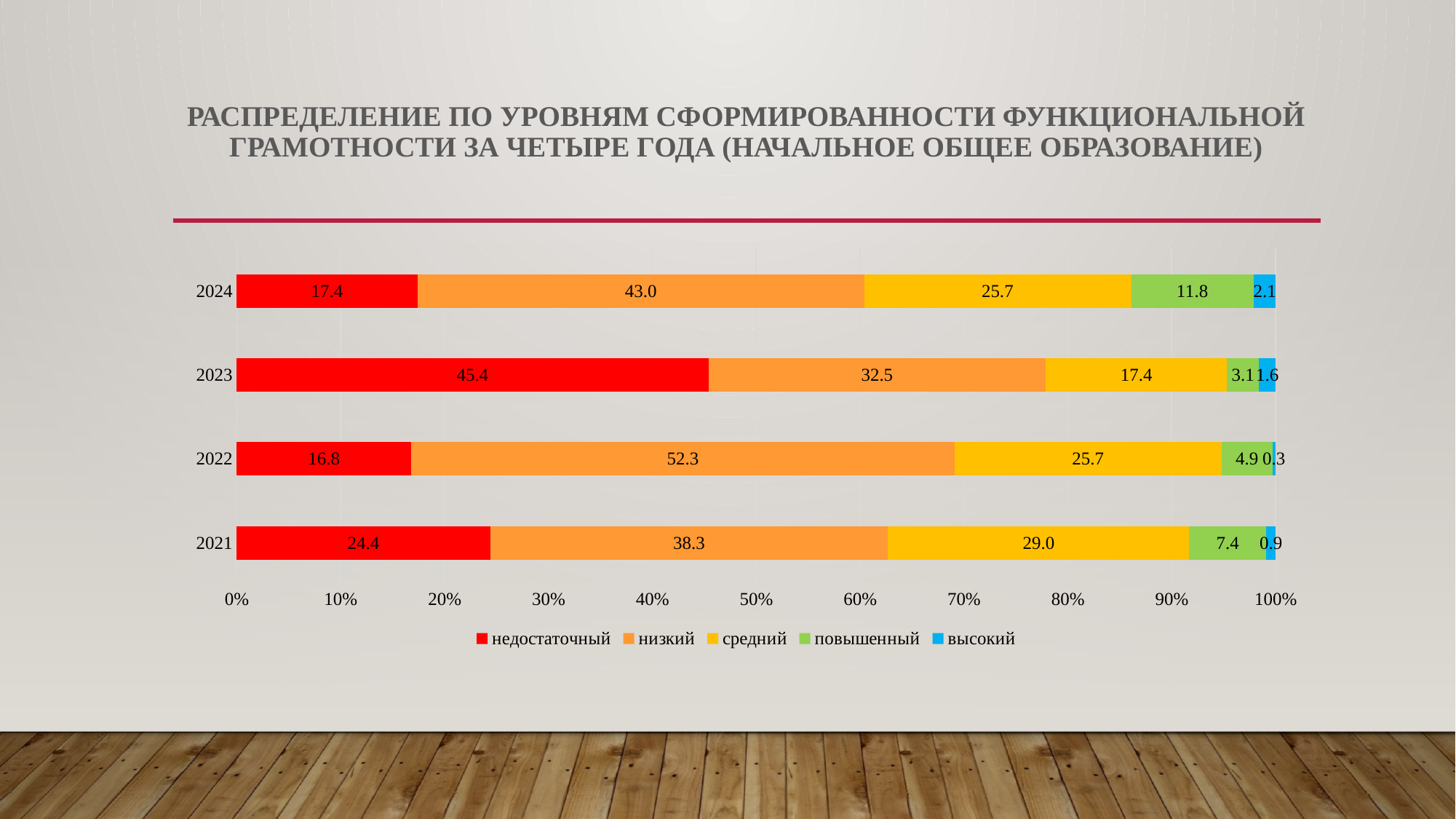
What is the value for недостаточный in 2023? 45.4 How many series does the legend list? 5 What is the value for повышенный in 2021? 7.4 Which year has the highest value for недостаточный? 2023 What is the difference between the повышенный values for 2024 and 2023? 8.7 What kind of chart is shown on the slide? Stacked bar chart Which year has the lowest value for высокий? 2022 Which is larger, the средний value for 2021 or for 2023? 2021 Which colour represents the series низкий in the chart? Orange How many years are shown on the chart? 4 What is the value for высокий in 2024? 2.1 What is the value for низкий in 2022? 52.3